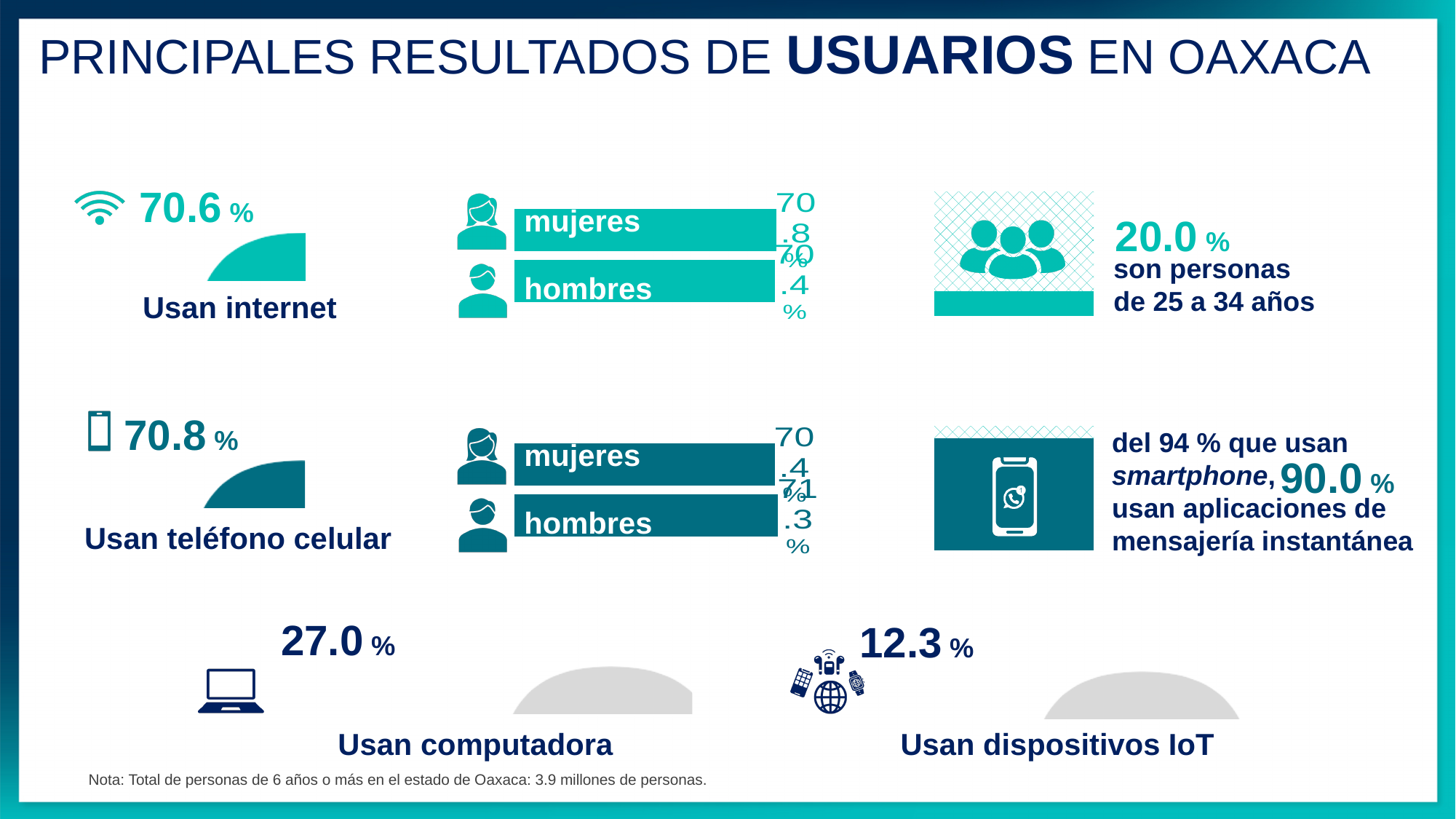
In the bar chart next to 'Usan teléfono celular', which group has the higher value, mujeres or hombres? hombres In the bar chart next to 'Usan internet', what is the value for mujeres? 70.8 % In the bar chart next to 'Usan internet', what is the value for hombres? 70.4 % What is the difference between the 'Usan computadora' value and the 'Usan dispositivos IoT' value? 14.7 % What percentage of people use a cell phone, according to the 'Usan teléfono celular' chart? 70.8 % Which is larger, the percentage that uses a computer or the percentage that uses IoT devices? Usan computadora What percentage of people use IoT devices, according to the 'Usan dispositivos IoT' chart? 12.3 % How many categories does the bar chart next to 'Usan teléfono celular' show? 2 What percentage of people in Oaxaca use the internet, according to the 'Usan internet' chart? 70.6 % What kind of chart is used to show the mujeres and hombres values next to 'Usan internet'? bar chart In the bar chart next to 'Usan teléfono celular', what is the value for hombres? 71.3 % What percentage of people use a computer, according to the 'Usan computadora' chart? 27.0 %